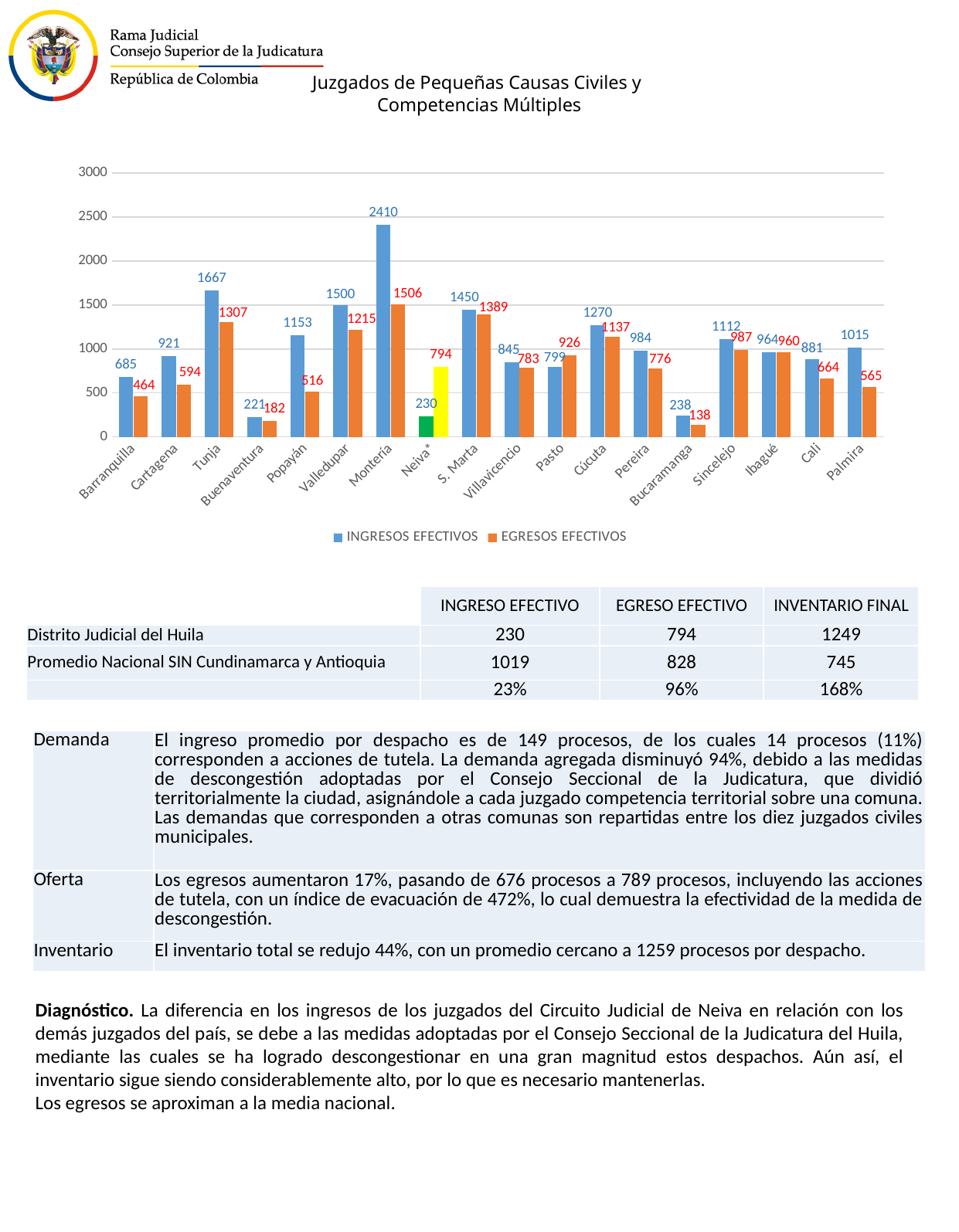
What is the INGRESOS EFECTIVOS value for Buenaventura? 221 Is the INGRESOS EFECTIVOS value for Valledupar greater or less than 1000? greater What is the INGRESOS EFECTIVOS value for Montería? 2410 What is the EGRESOS EFECTIVOS value for Neiva*? 794 What is the difference between INGRESOS EFECTIVOS and EGRESOS EFECTIVOS for Tunja? 360 What type of chart is shown on the slide? bar chart How many series does the chart legend list? 2 Which is larger for Pasto, INGRESOS EFECTIVOS or EGRESOS EFECTIVOS? EGRESOS EFECTIVOS How many cities are shown on the x axis of the chart? 18 What colour are the INGRESOS EFECTIVOS bars in the chart legend? blue Which city has the highest INGRESOS EFECTIVOS value? Montería Which city has the lowest EGRESOS EFECTIVOS value? Bucaramanga